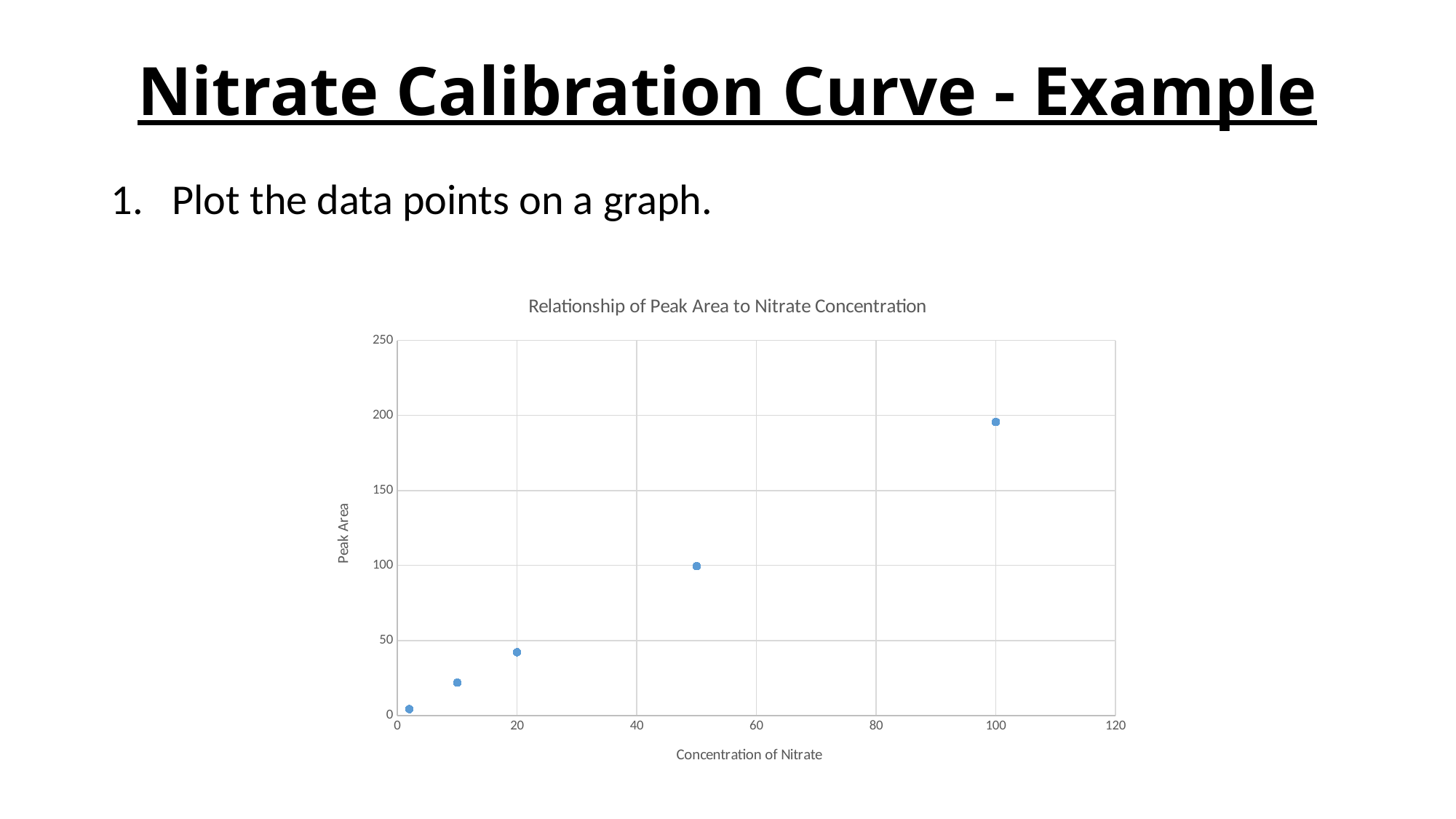
Is the peak area for the point at a nitrate concentration of 100 greater or less than 150? greater At which nitrate concentration is the peak area highest? 100 Which point has the larger peak area: the one at concentration 20 or the one at concentration 100? The one at concentration 100 Does the peak area rise or fall as the concentration of nitrate increases? Rises What is the title of the chart? Relationship of Peak Area to Nitrate Concentration How many data points are plotted on the chart? 5 Is the peak area for the point at a nitrate concentration of 20 greater or less than 50? less What is the label of the vertical axis? Peak Area What kind of chart is shown on the slide? Scatter chart